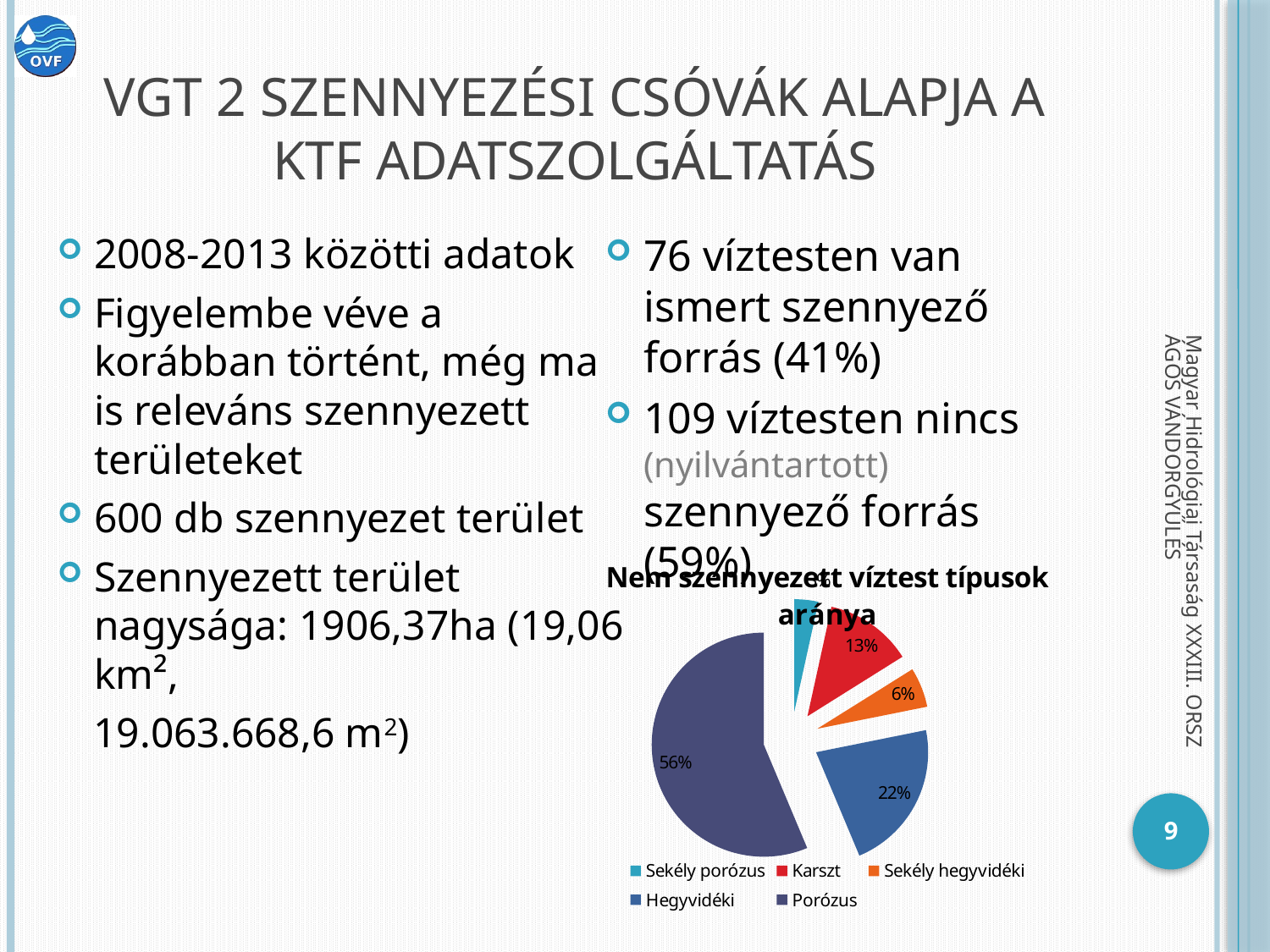
Which category has the largest slice of the pie? Porózus Which category has the smallest slice of the pie? Sekély porózus What share of the pie does Hegyvidéki have? 22% What share of the pie does Sekély hegyvidéki have? 6% How many percentage points larger is the Porózus slice than the Hegyvidéki slice? 34 What share of the pie does Porózus have? 56% What type of chart is shown on the slide? pie chart What colour is the Karszt slice in the pie chart? red What share of the pie does Karszt have? 13% How many categories does the pie chart legend list? 5 What is the title of the pie chart? Nem szennyezett víztest típusok aránya Which slice is larger, Karszt or Sekély hegyvidéki? Karszt